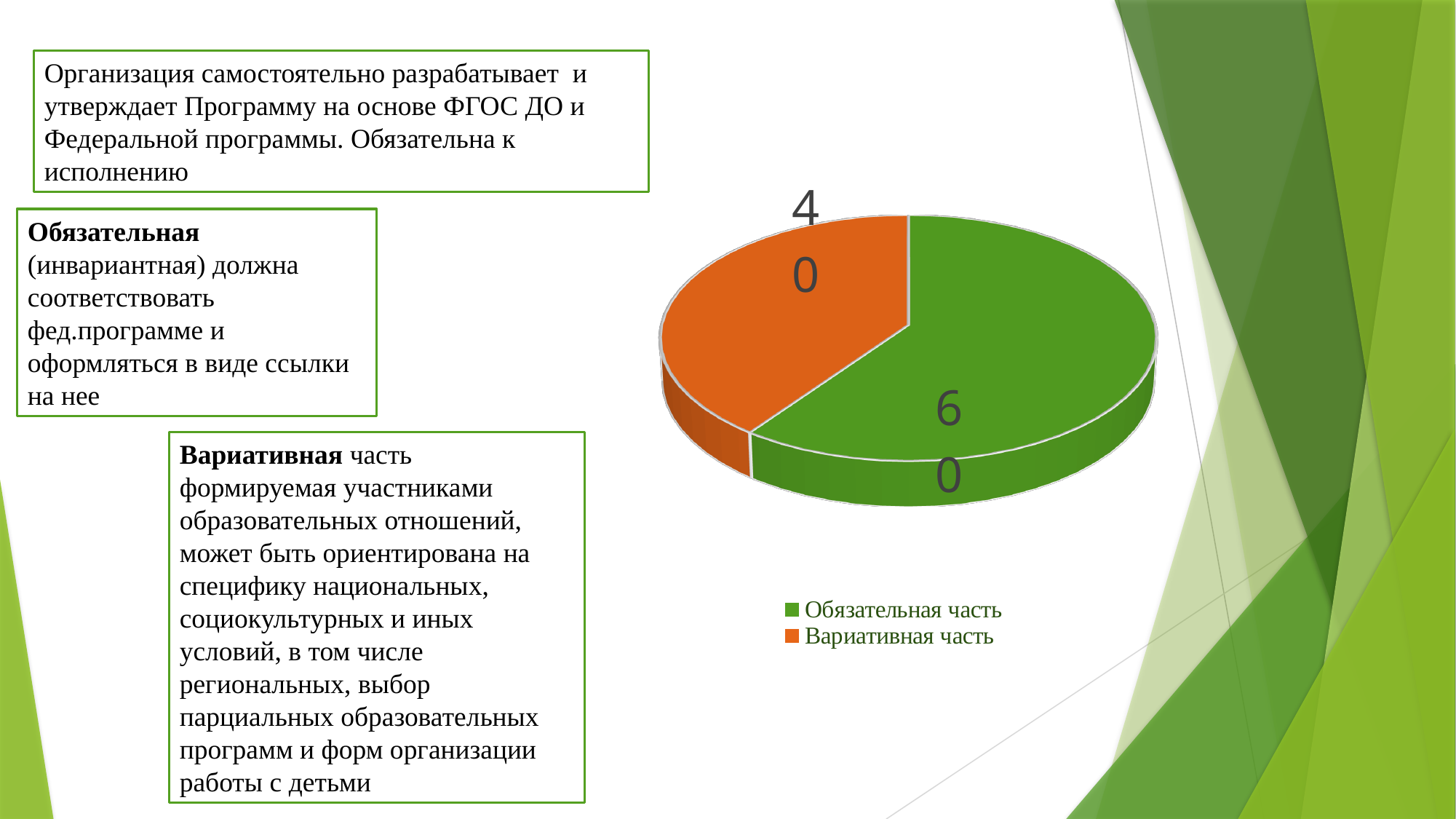
How many slices does the pie chart have? 2 How many entries does the legend list? 2 What share of the pie does Обязательная часть represent? 60% Which slice of the pie chart is the largest? Обязательная часть What colour is the slice for Обязательная часть? green Which is larger, Обязательная часть or Вариативная часть? Обязательная часть What kind of chart is shown on the slide? pie chart What is the value shown for Вариативная часть? 40 What colour is the slice for Вариативная часть? orange What is the difference between the values for Обязательная часть and Вариативная часть? 20 What is the value shown for Обязательная часть? 60 Which slice of the pie chart is the smallest? Вариативная часть